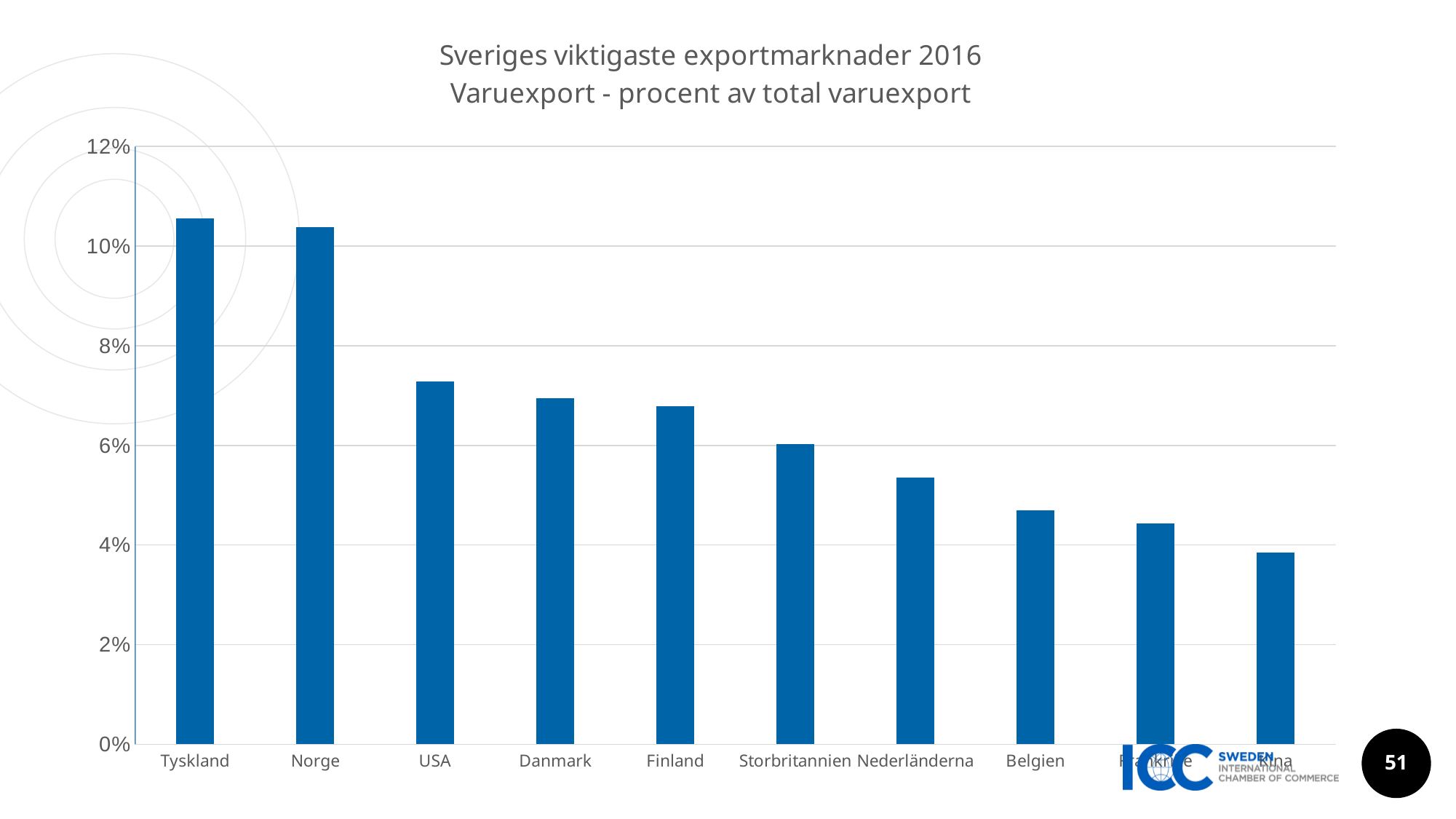
Is the value for USA greater or less than 8%? less Is the value for Tyskland greater or less than 10%? greater Do the values rise or fall from left to right along the x axis? fall How many countries are shown on the x axis of the chart? 10 Which has the larger value, USA or Danmark? USA Is the value for Danmark greater or less than 6%? greater What is the first line of the chart title? Sveriges viktigaste exportmarknader 2016 Which has the larger value, Finland or Storbritannien? Finland What kind of chart is shown on the slide? bar chart